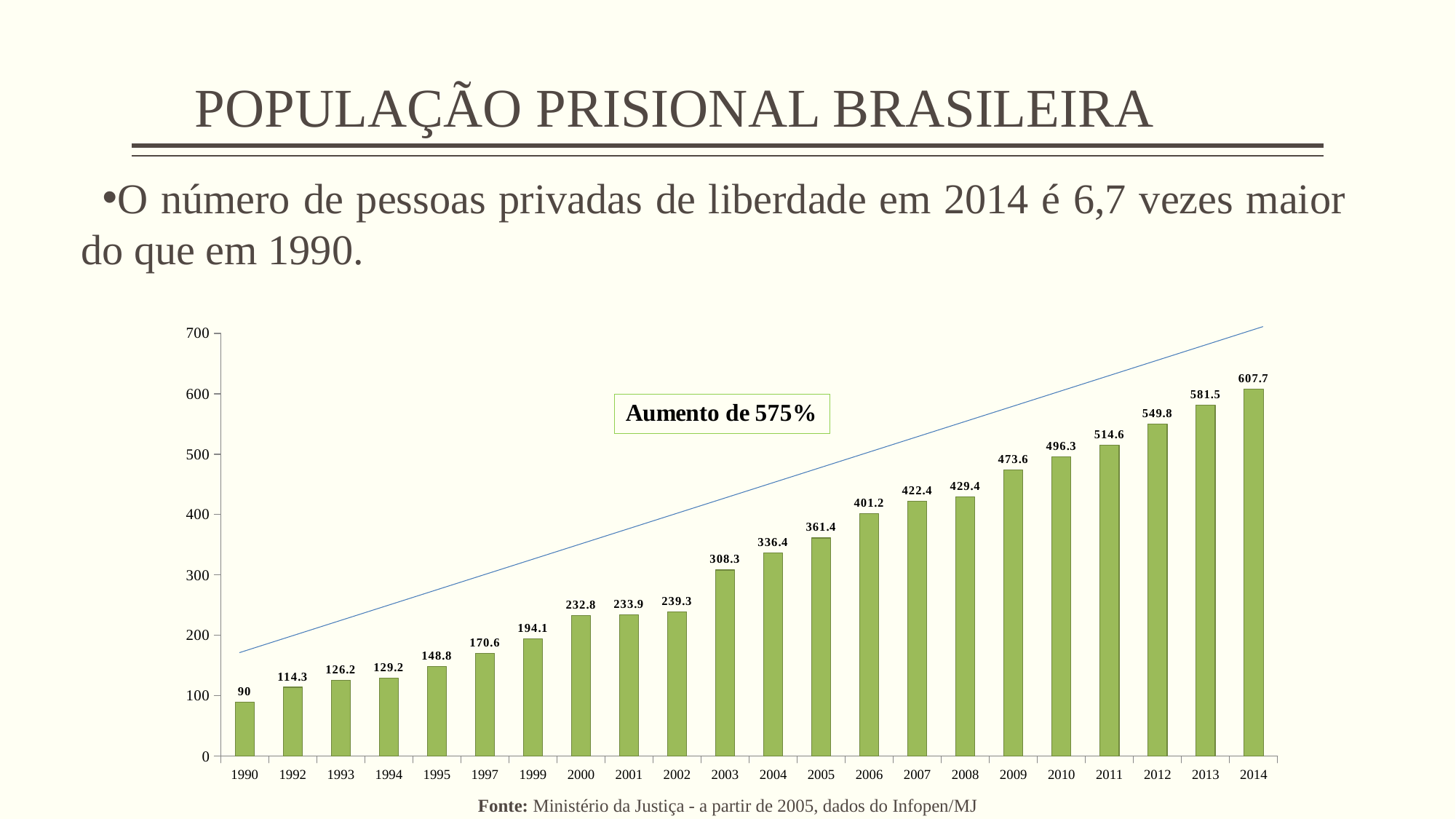
Do the values rise or fall from 1990 to 2014? rise What is the value for 1990? 90 What is the difference between the values for 2014 and 1990? 517.7 What is the value for 2009? 473.6 Which year has the lowest value? 1990 What is the value for 2014? 607.7 How many years are shown on the x axis? 22 What is the value for 2005? 361.4 What kind of chart is this? bar chart Which year has the highest value? 2014 Which is larger, the value for 2003 or the value for 2002? 2003 What is the difference between the values for 2013 and 2012? 31.7